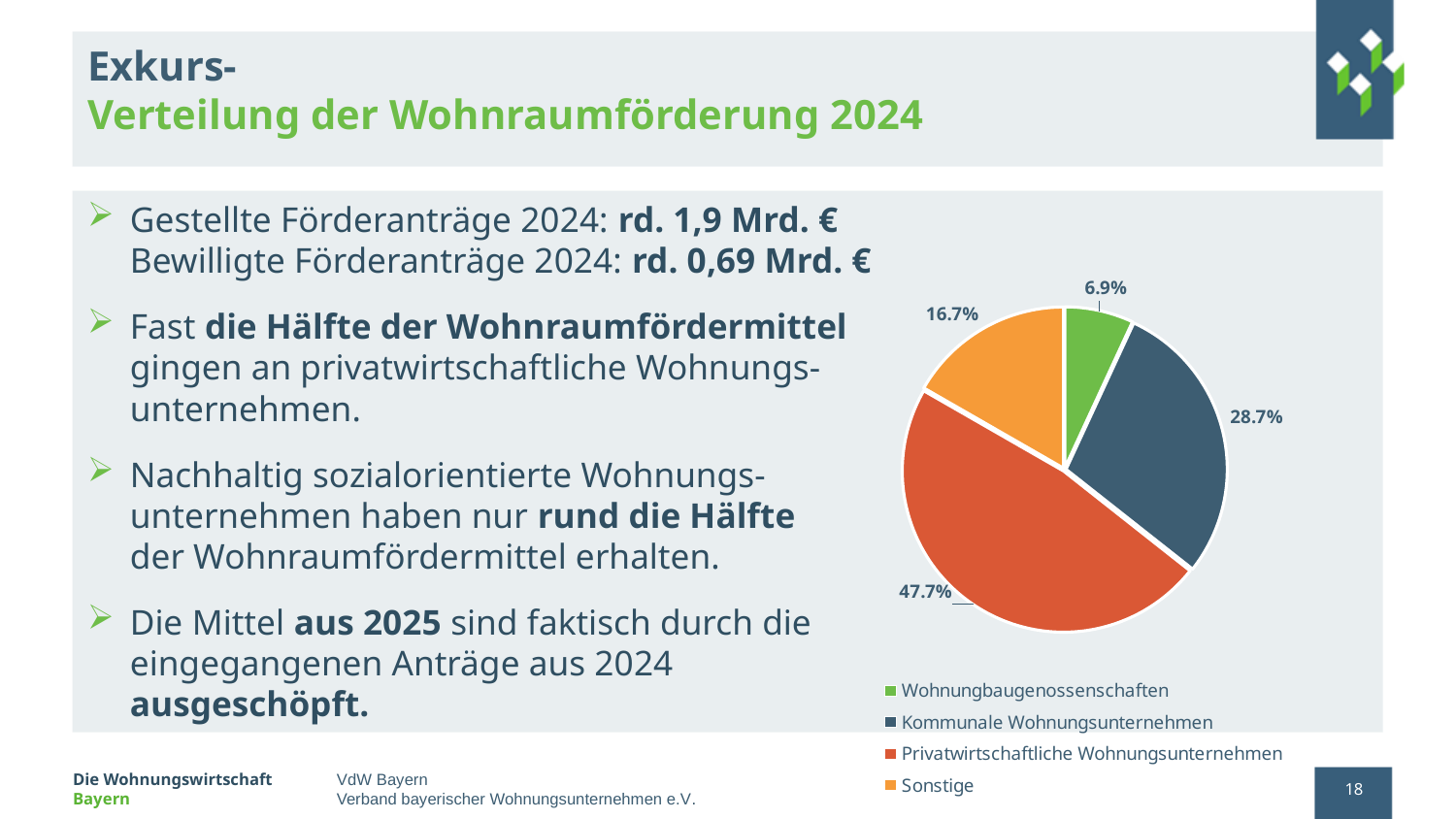
What is the combined share of Kommunale Wohnungsunternehmen and Wohnungbaugenossenschaften? 35.6% How many categories does the pie chart show? 4 What is the difference in percentage points between Privatwirtschaftliche Wohnungsunternehmen and Kommunale Wohnungsunternehmen? 19.0 percentage points Which colour represents Kommunale Wohnungsunternehmen in the pie chart? dark blue What share of the pie chart is Sonstige? 16.7% What share of the pie chart is Privatwirtschaftliche Wohnungsunternehmen? 47.7% What share of the pie chart is Wohnungbaugenossenschaften? 6.9% What share of the pie chart is Kommunale Wohnungsunternehmen? 28.7% Which category has the smallest slice of the pie chart? Wohnungbaugenossenschaften Which is larger in the pie chart: Sonstige or Wohnungbaugenossenschaften? Sonstige Which category has the largest slice of the pie chart? Privatwirtschaftliche Wohnungsunternehmen What kind of chart is shown on the slide? pie chart